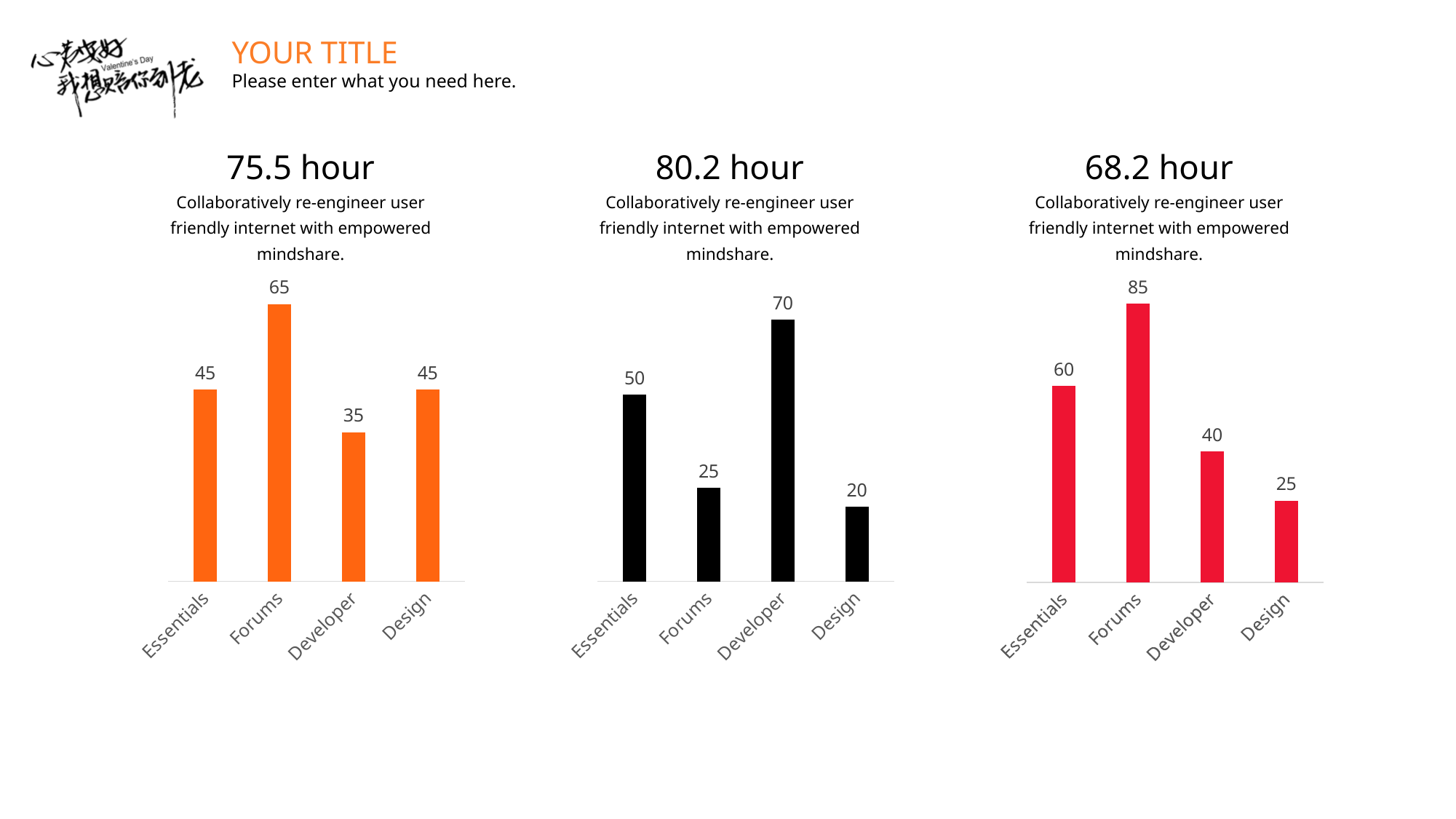
In the middle (black) chart, what is the value for Developer? 70 In the right (red) chart, what is the value for Design? 25 In the middle (black) chart, what is the difference between the values for Developer and Forums? 45 In the left (orange) chart, what is the value for Forums? 65 In the left (orange) chart, which category has the lowest value? Developer In the middle (black) chart, which category has the lowest value? Design In the right (red) chart, what is the difference between the values for Forums and Essentials? 25 In the right (red) chart, which category has the highest value? Forums How many categories does the middle (black) chart show? 4 In the left (orange) chart, which is larger, the value for Forums or the value for Developer? Forums What colour are the bars in the left chart? Orange What kind of chart is the right (red) chart? Bar chart